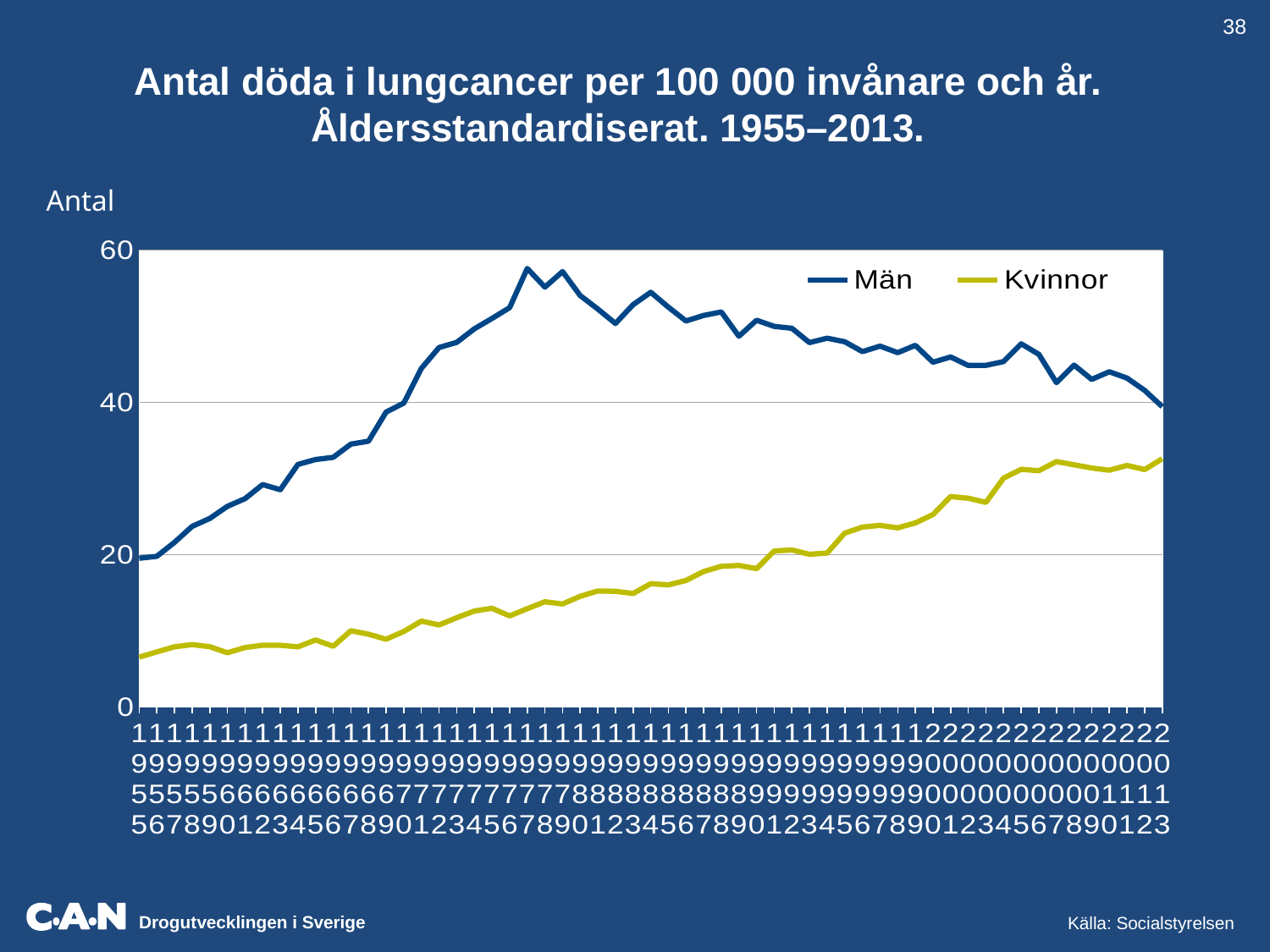
Is the value for Kvinnor in 1980 greater or less than 20? less Which series has the higher value in 2013, Män or Kvinnor? Män How many series does the legend list? 2 Which series reaches the highest value anywhere on the chart? Män Is the value for Kvinnor in 1955 greater or less than 20? less Is the highest value reached by the Män line greater or less than 40? greater What is the label on the vertical axis? Antal What kind of chart is shown on the slide? line chart What are the two series named in the legend? Män and Kvinnor Does the Kvinnor line generally rise or fall from 1955 to 2013? rise